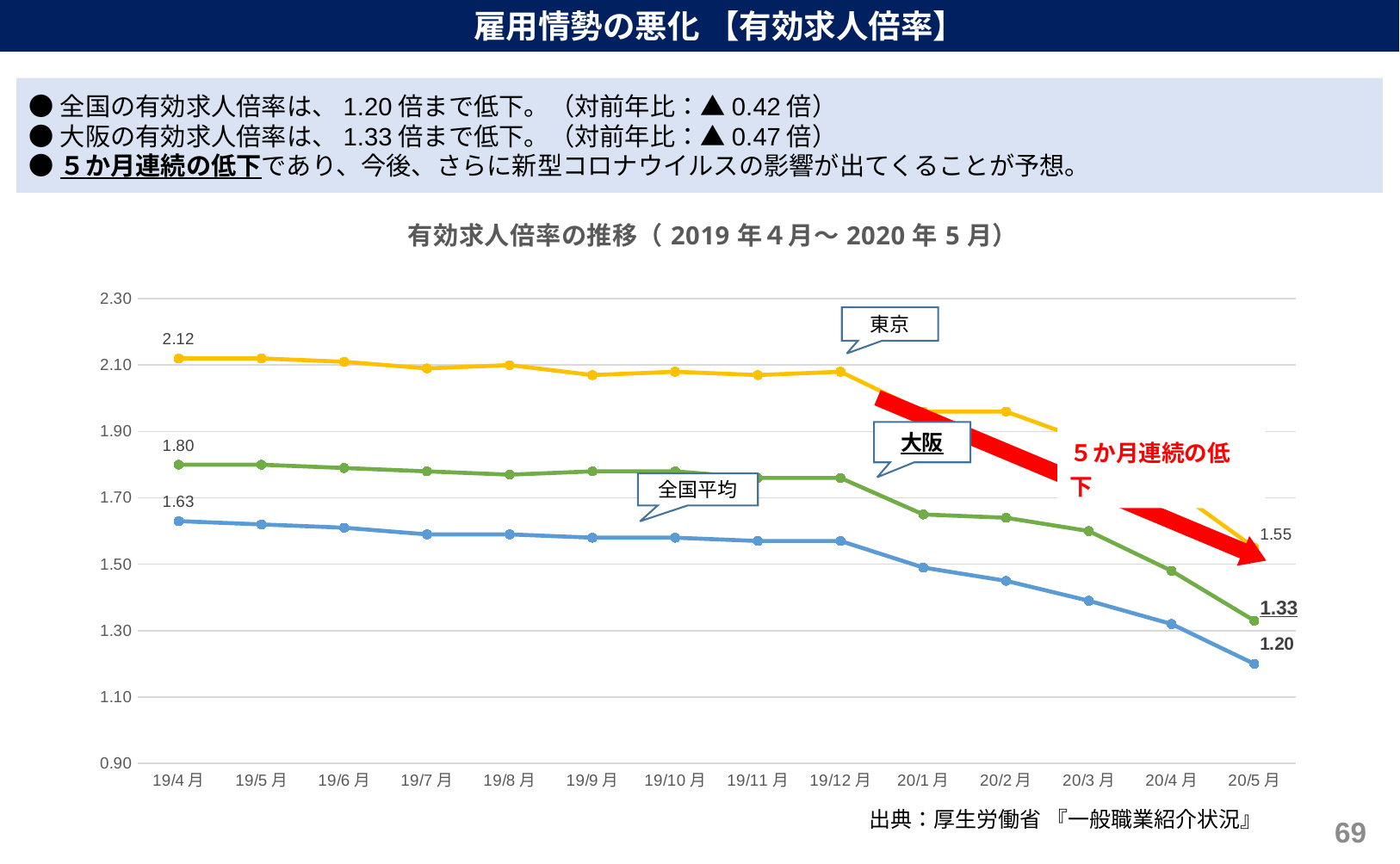
How many months are plotted on the x axis? 14 What is the value for 全国平均 at 19/4月? 1.63 What is the value for 大阪 at 19/4月? 1.80 Which series has the highest value at 19/4月? 東京 By how much did the 大阪 value fall from 19/4月 to 20/5月? 0.47 Is the value for 東京 at 19/12月 greater or less than 1.90? greater What is the value for 大阪 at 20/5月? 1.33 Do the values rise or fall along the x axis from 19/4月 to 20/5月? fall What kind of chart is shown on the slide? line chart What is the value for 全国平均 at 20/5月? 1.20 How many series are plotted in the chart? 3 What is the value for 東京 at 19/4月? 2.12